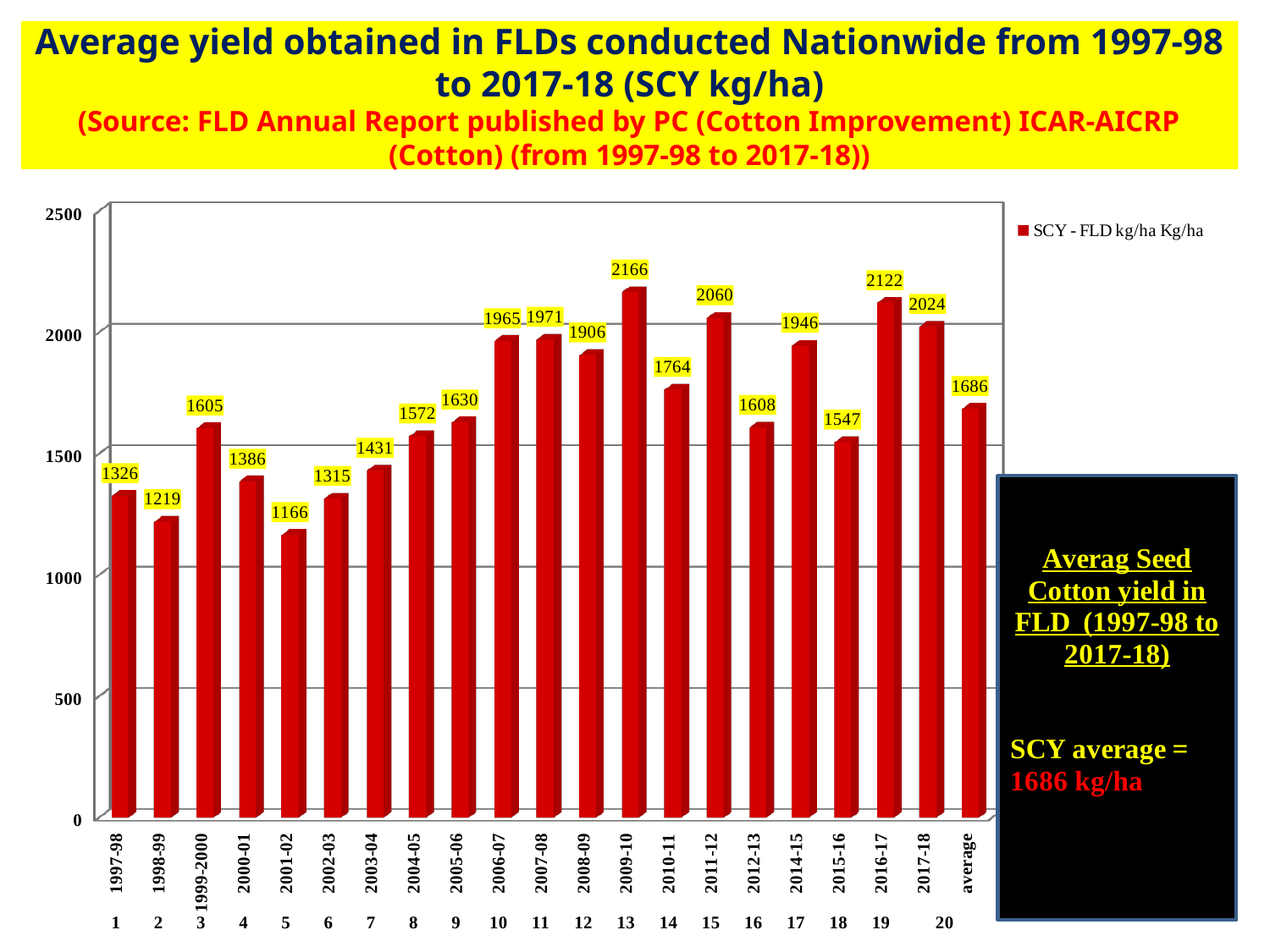
What is the value for 2001-02? 1166 How many bars are plotted in the chart, including the average bar? 21 What kind of chart is shown? bar chart Which is larger, the value for 2006-07 or the value for 2007-08? 2007-08 Which year has the highest value? 2009-10 What is the value for 2009-10? 2166 What is the value shown for the 'average' bar? 1686 Is the value for 2011-12 greater or less than 2000? greater How many series does the legend list? 1 Which year has the lowest value? 2001-02 What is the difference between the values for 2016-17 and 2017-18? 98 What is the legend entry for the series? SCY - FLD kg/ha Kg/ha